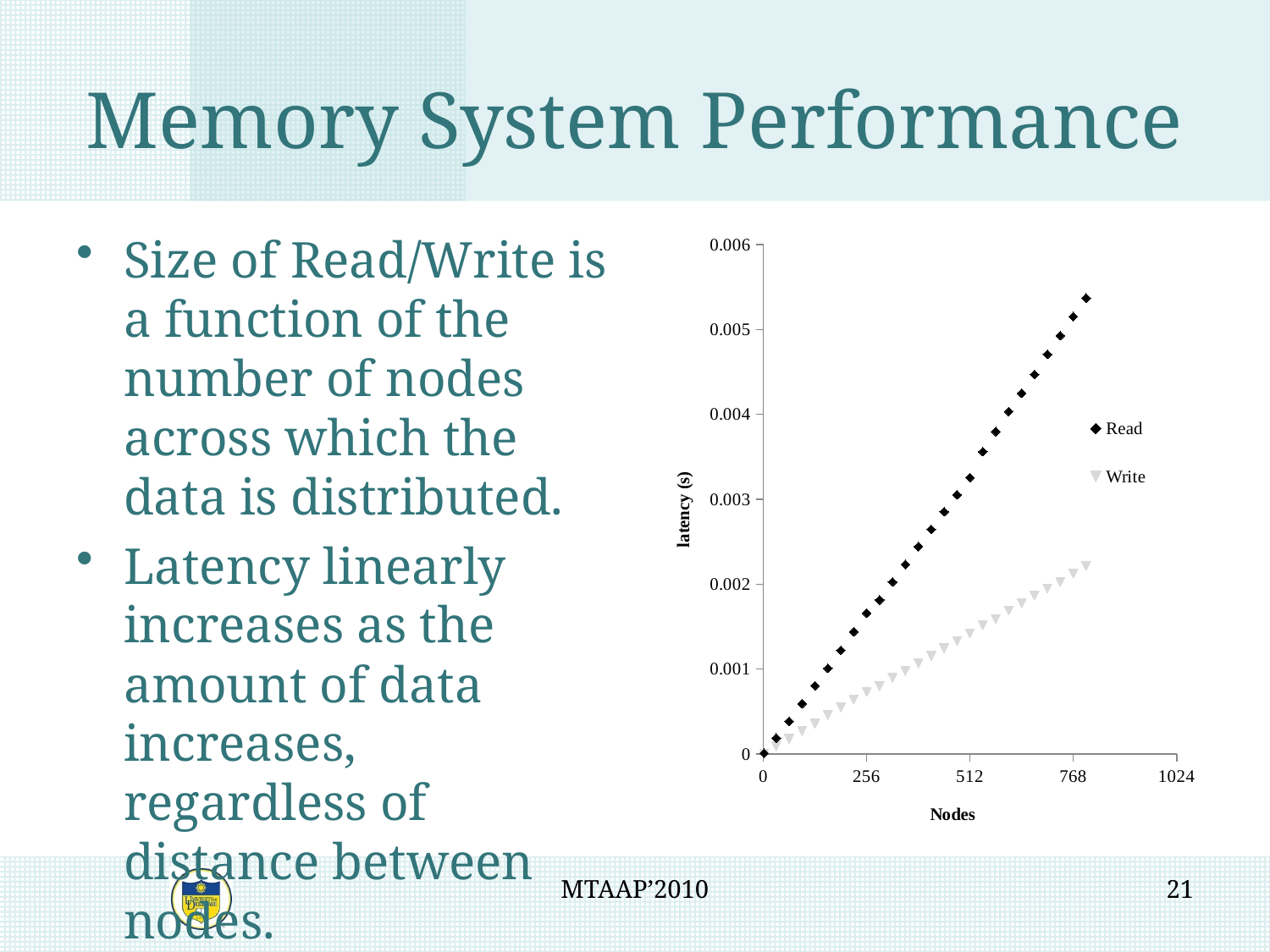
At 768 nodes, which series has the higher latency, Read or Write? Read Which series reaches the highest latency on the chart? Read Does the Write latency rise or fall as the number of nodes increases? Rise Does the Read latency rise or fall as the number of nodes increases? Rise Is the Read latency at 512 nodes greater or less than 0.003? greater How many series does the chart's legend list? 2 Is the Write latency at 768 nodes greater or less than 0.003? less What is the label of the chart's y axis? latency (s) What kind of chart is shown on the slide? Scatter chart What are the two series named in the chart's legend? Read and Write Is the Write latency at 512 nodes greater or less than 0.002? less